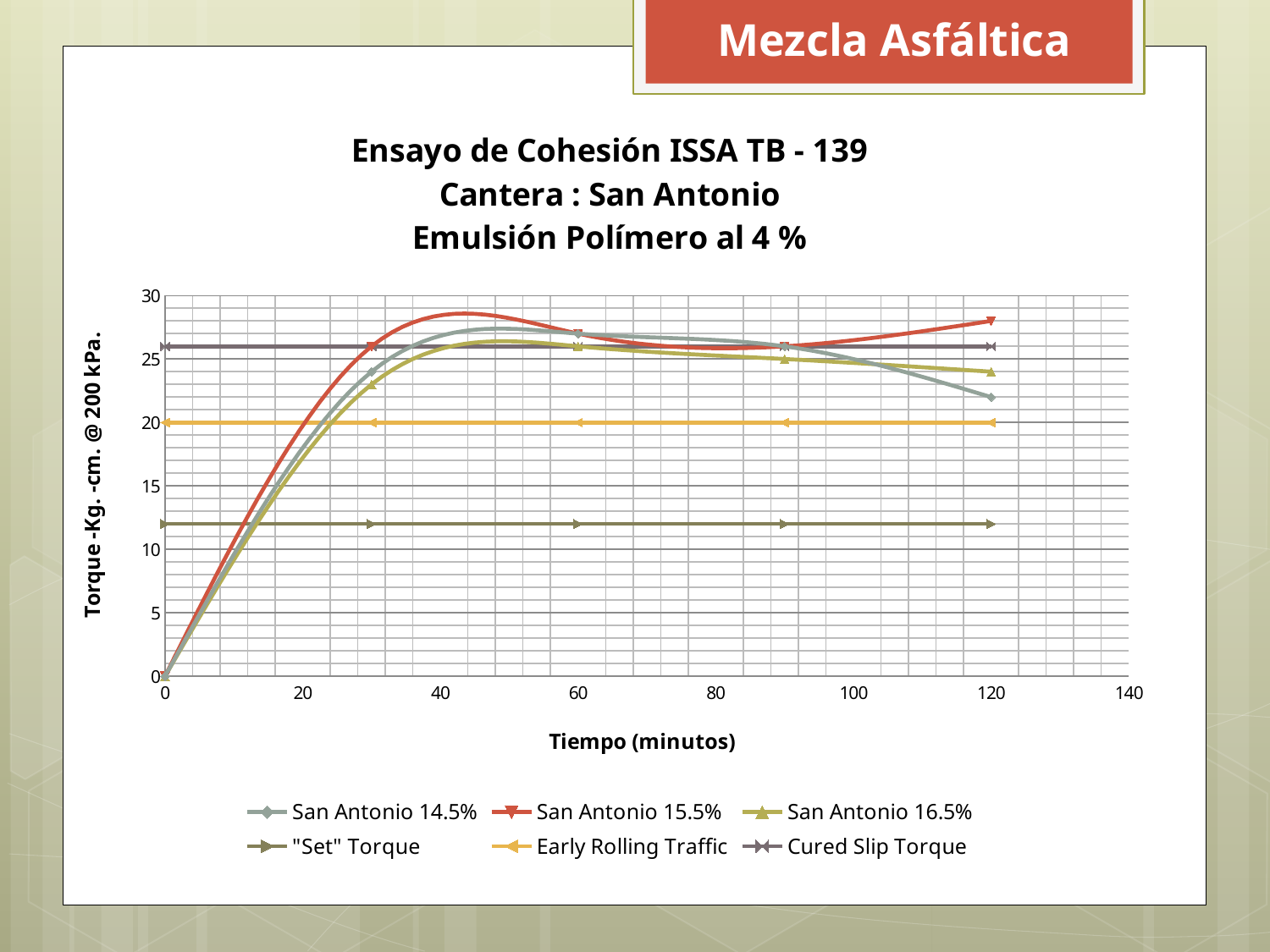
What kind of chart is shown on the slide? line chart What is the value of the Early Rolling Traffic line? 20 Is the value for San Antonio 14.5% at 120 minutes greater or less than 25? less What is the title of the x axis? Tiempo (minutos) How many series does the legend list? 6 Is the value for San Antonio 15.5% at 120 minutes greater or less than 25? greater Is the value of the "Set" Torque line greater or less than 10? greater At 120 minutes, which is larger: San Antonio 15.5% or San Antonio 14.5%? San Antonio 15.5% Does the San Antonio 14.5% series rise or fall between 60 and 120 minutes? fall Of the three San Antonio series, which has the lowest value at 120 minutes? San Antonio 14.5% Which series has the highest value at 120 minutes? San Antonio 15.5%